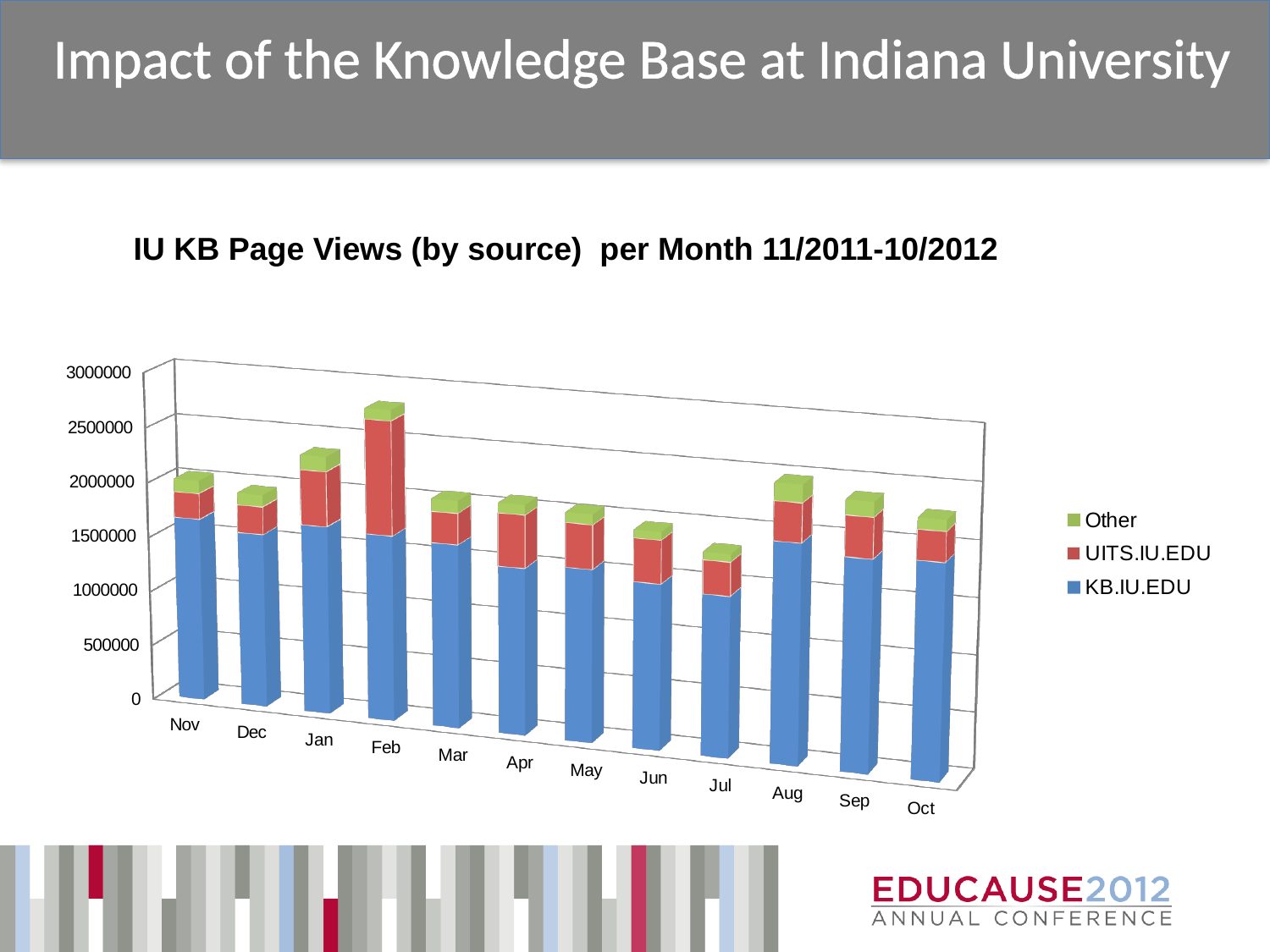
Which month has the lowest total page views? Jul Which month has the highest total page views? Feb How many months are plotted along the x axis of the chart? 12 Is the KB.IU.EDU value for Aug greater or less than 1000000? greater Which month has the larger total page views, Aug or Jul? Aug What kind of chart is shown on the slide? Stacked bar chart Do the total page views rise or fall from Feb to Jul? fall Which month has the larger total page views, Jan or Dec? Jan Is the total value for Feb greater or less than 2000000? greater What is the title of the chart? IU KB Page Views (by source) per Month 11/2011-10/2012 Is the total value for Jul greater or less than 2000000? less How many series does the chart's legend list? 3